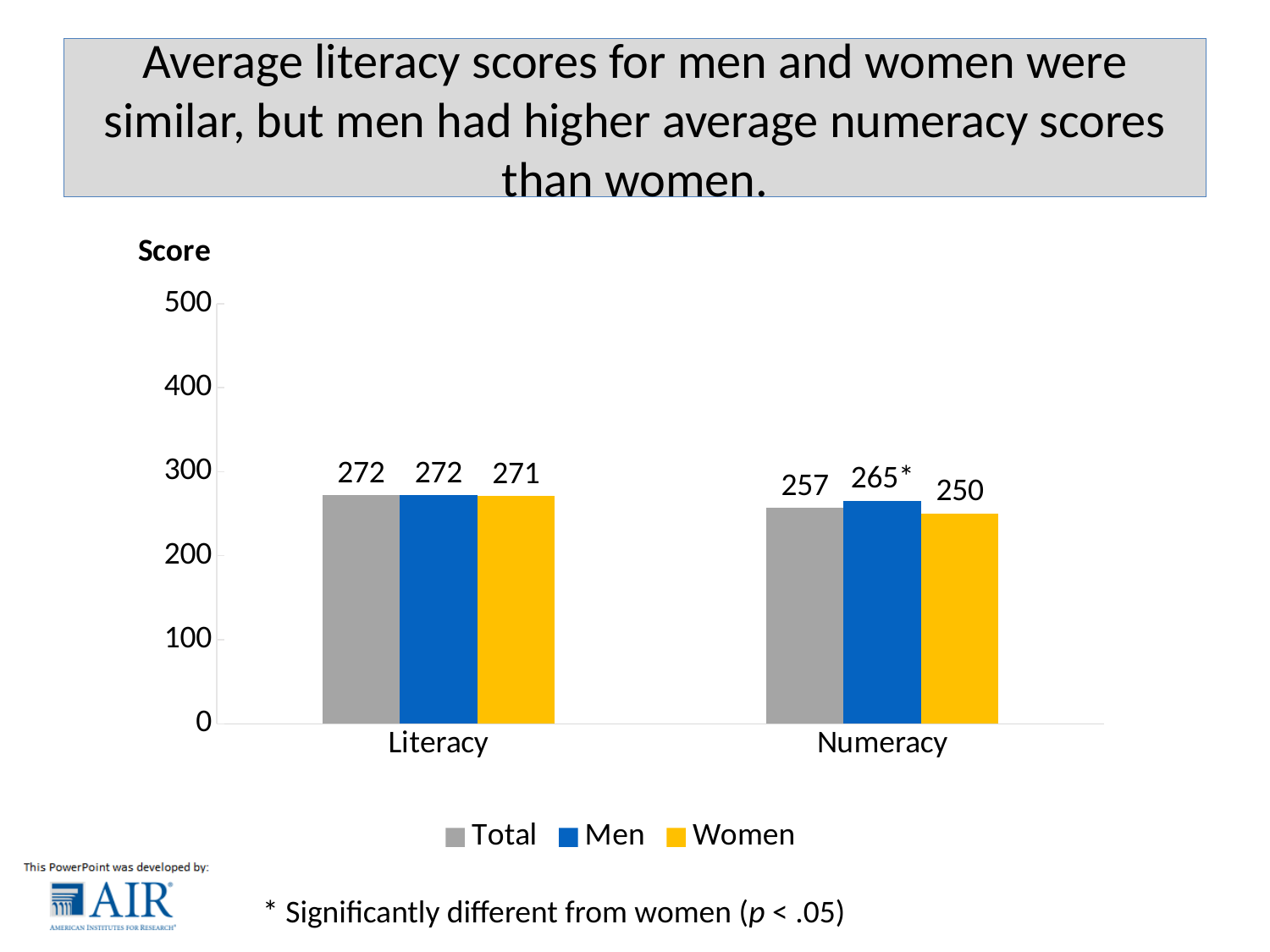
What is the difference between the Men and Women scores for Numeracy? 15 Which series has the highest score for Numeracy? Men Which series has the lowest score for Numeracy? Women What is the label on the vertical axis of the chart? Score What kind of chart is shown on the slide? Bar chart What is the Men score for Numeracy? 265 What is the Women score for Numeracy? 250 What is the Total score for Literacy? 272 What is the Women score for Literacy? 271 Is the Men score for Numeracy greater or less than 300? less How many series does the legend list? 3 What is the difference between the Total scores for Literacy and Numeracy? 15